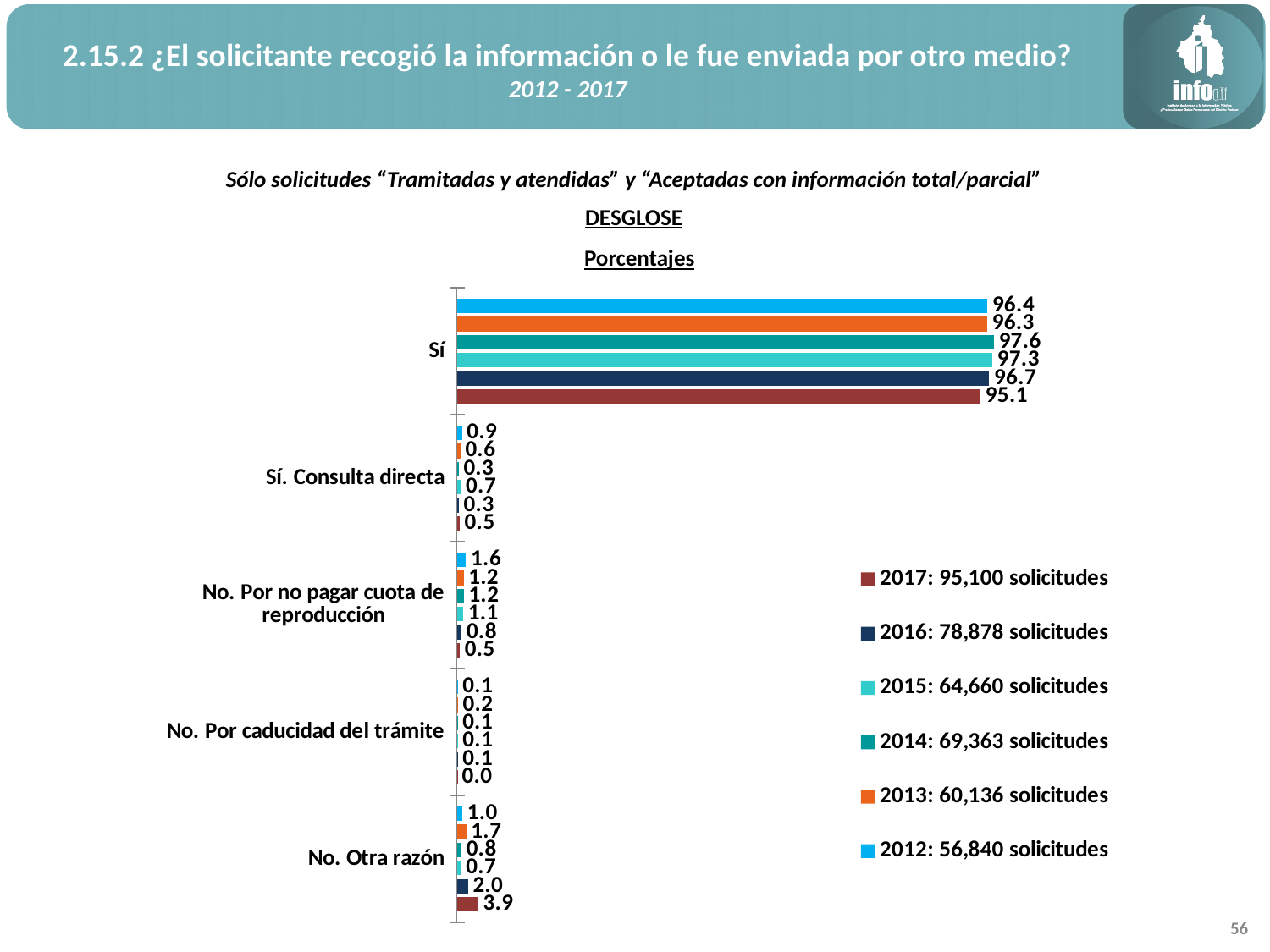
According to the legend, how many solicitudes were there in 2015? 64,660 solicitudes What is the difference between the 2017 and 2016 values for "No. Otra razón"? 1.9 How many series does the legend list? 6 What is the value for "No. Otra razón" in 2017? 3.9 Which year has the highest value for "Sí"? 2014 What is the value for "No. Por caducidad del trámite" in 2017? 0.0 What is the value for "Sí" in 2014? 97.6 What kind of chart is shown on the slide? Bar chart Which is larger for "Sí. Consulta directa": the 2012 value or the 2013 value? 2012 How many categories are shown on the chart? 5 What is the value for "No. Por no pagar cuota de reproducción" in 2012? 1.6 Which year has the lowest value for "Sí"? 2017